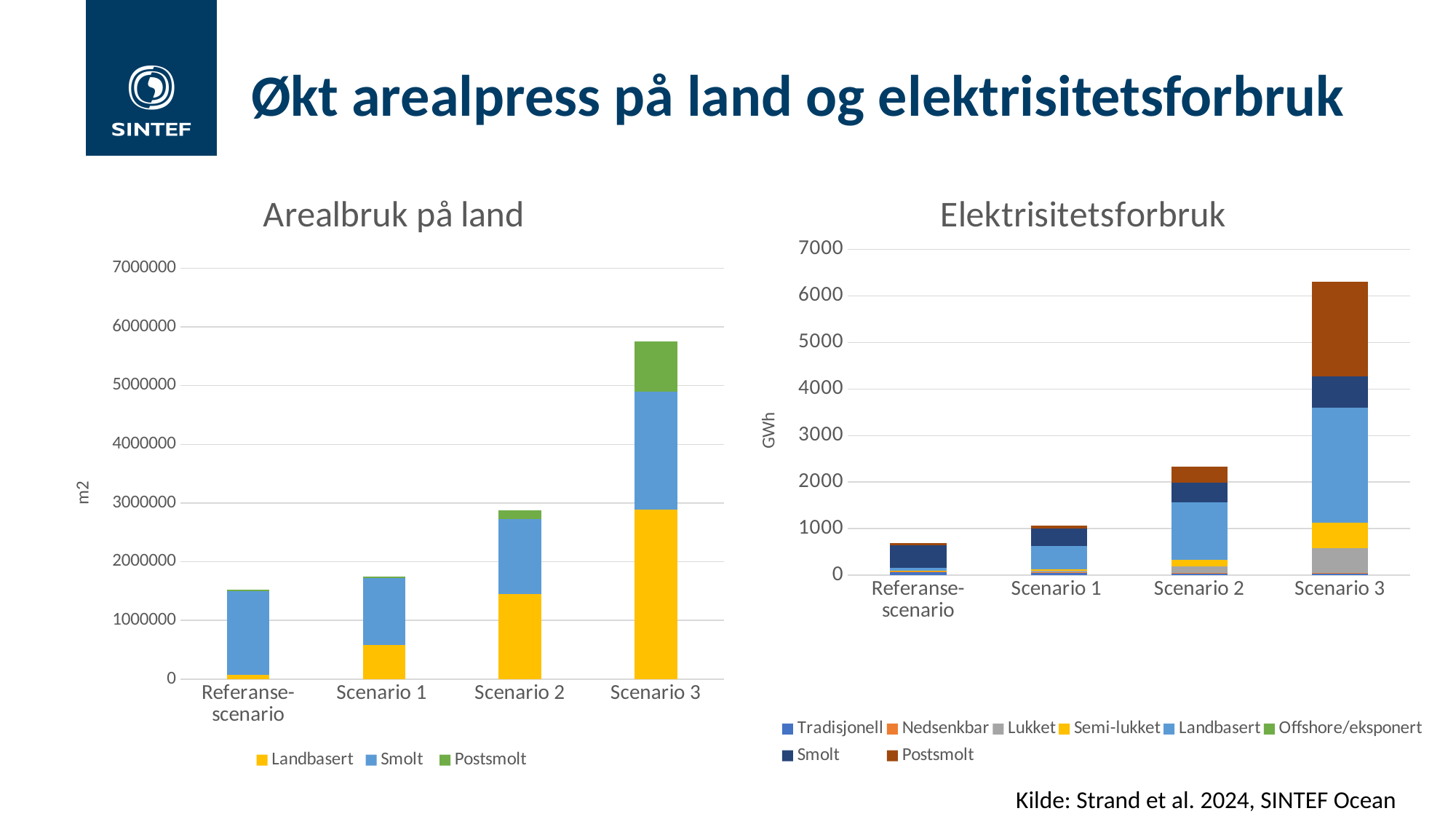
How many series does the legend of the 'Arealbruk på land' chart list? 3 In the 'Elektrisitetsforbruk' chart, how many scenarios are shown on the x axis? 4 What unit is shown on the y axis of the 'Elektrisitetsforbruk' chart? GWh What kind of chart is the 'Arealbruk på land' chart? stacked bar chart In the 'Elektrisitetsforbruk' chart, do the total values rise or fall from the Referanse-scenario to Scenario 3? rise How many series does the legend of the 'Elektrisitetsforbruk' chart list? 8 In the 'Arealbruk på land' chart, which scenario has the lowest total land use? Referanse-scenario In the 'Arealbruk på land' chart, which scenario has the highest total land use? Scenario 3 In the 'Arealbruk på land' chart, is the total for Scenario 2 greater or less than 3000000? less In the 'Elektrisitetsforbruk' chart, is the total for Scenario 3 greater or less than 6000? greater In the 'Elektrisitetsforbruk' chart, is the total for the Referanse-scenario greater or less than 1000? less